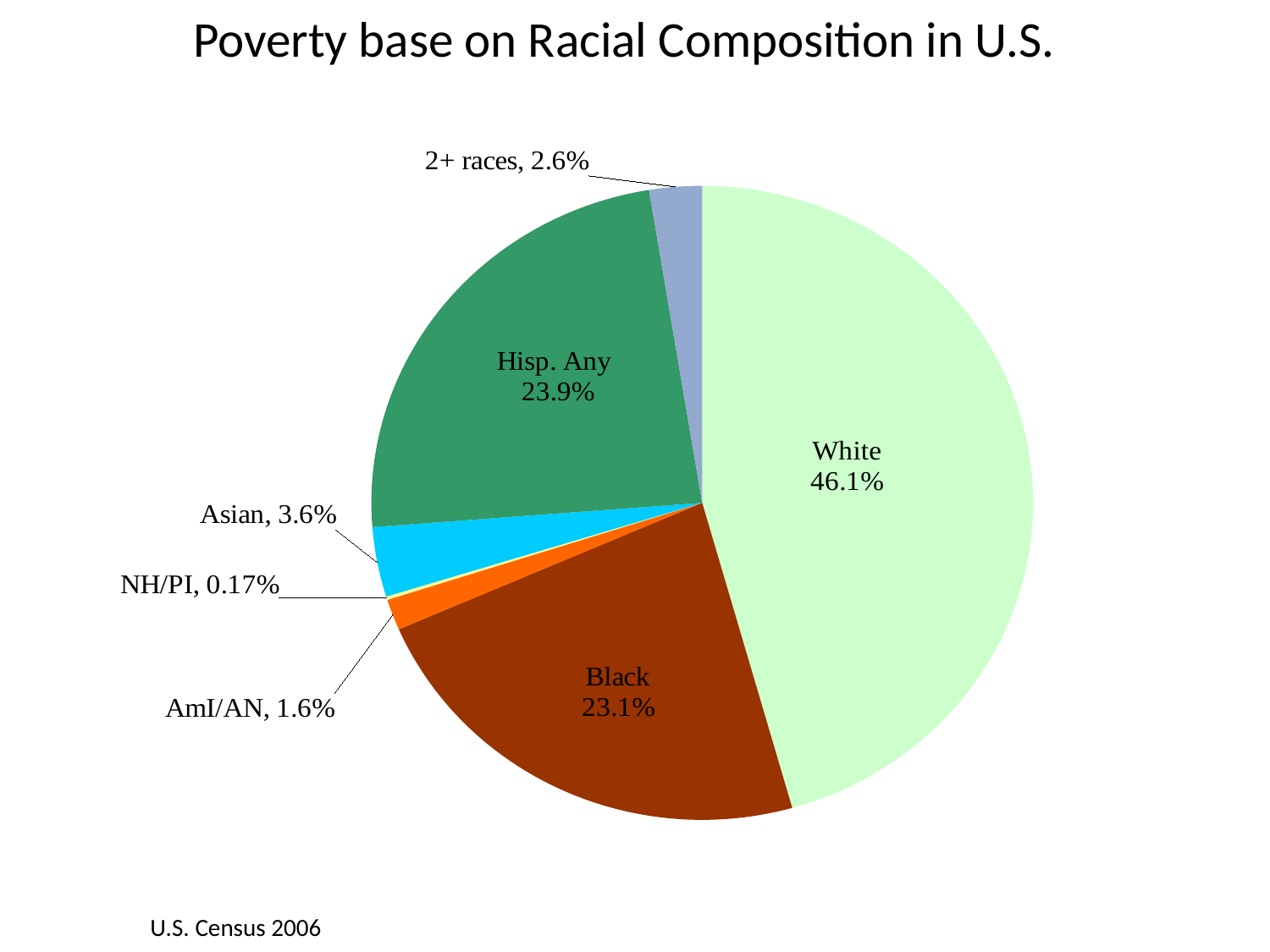
How many categories are shown in the pie chart? 7 Which category has the smallest slice of the pie? NH/PI What is the value shown for NH/PI? 0.17% What is the difference between the White and Black percentages? 23.0% What is the value shown for AmI/AN? 1.6% What is the title of the chart? Poverty base on Racial Composition in U.S. What share of the pie does the White slice represent? 46.1% What is the value shown for Black? 23.1% Which category has the largest slice of the pie? White What kind of chart is shown on the slide? Pie chart What is the value shown for Hisp. Any? 23.9% Which is larger, the Asian slice or the 2+ races slice? Asian